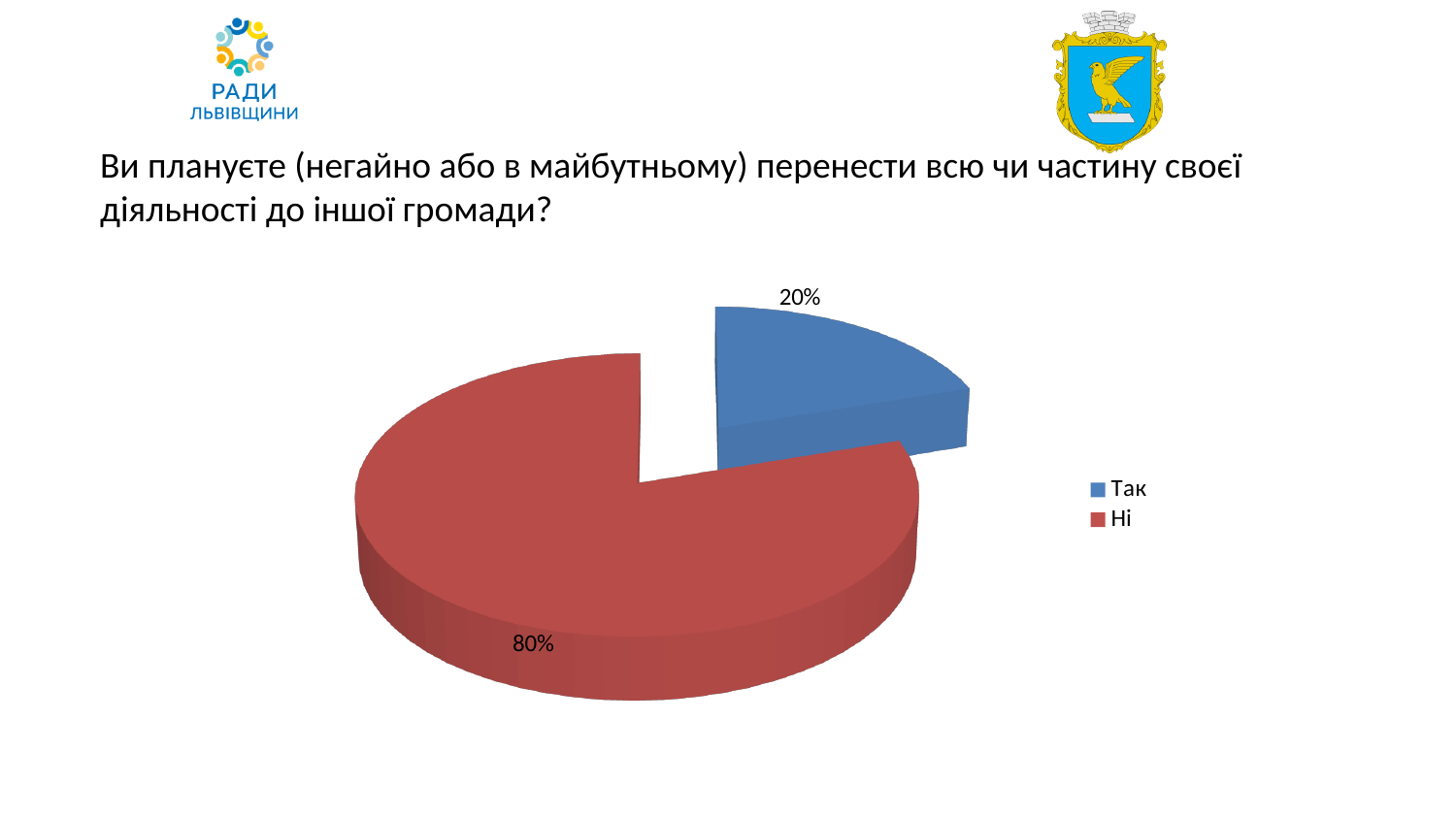
How many entries does the legend list? 2 What colour is the "Так" slice? blue Which is larger, the "Так" slice or the "Ні" slice? Ні What is the difference in percentage points between the "Ні" and "Так" slices? 60 What share of the pie does "Так" represent? 20% How many categories does the pie chart show? 2 What kind of chart is shown on the slide? pie chart Which category has the largest slice of the pie? Ні What colour is the "Ні" slice? red What share of the pie does "Ні" represent? 80% Which category has the smallest slice of the pie? Так